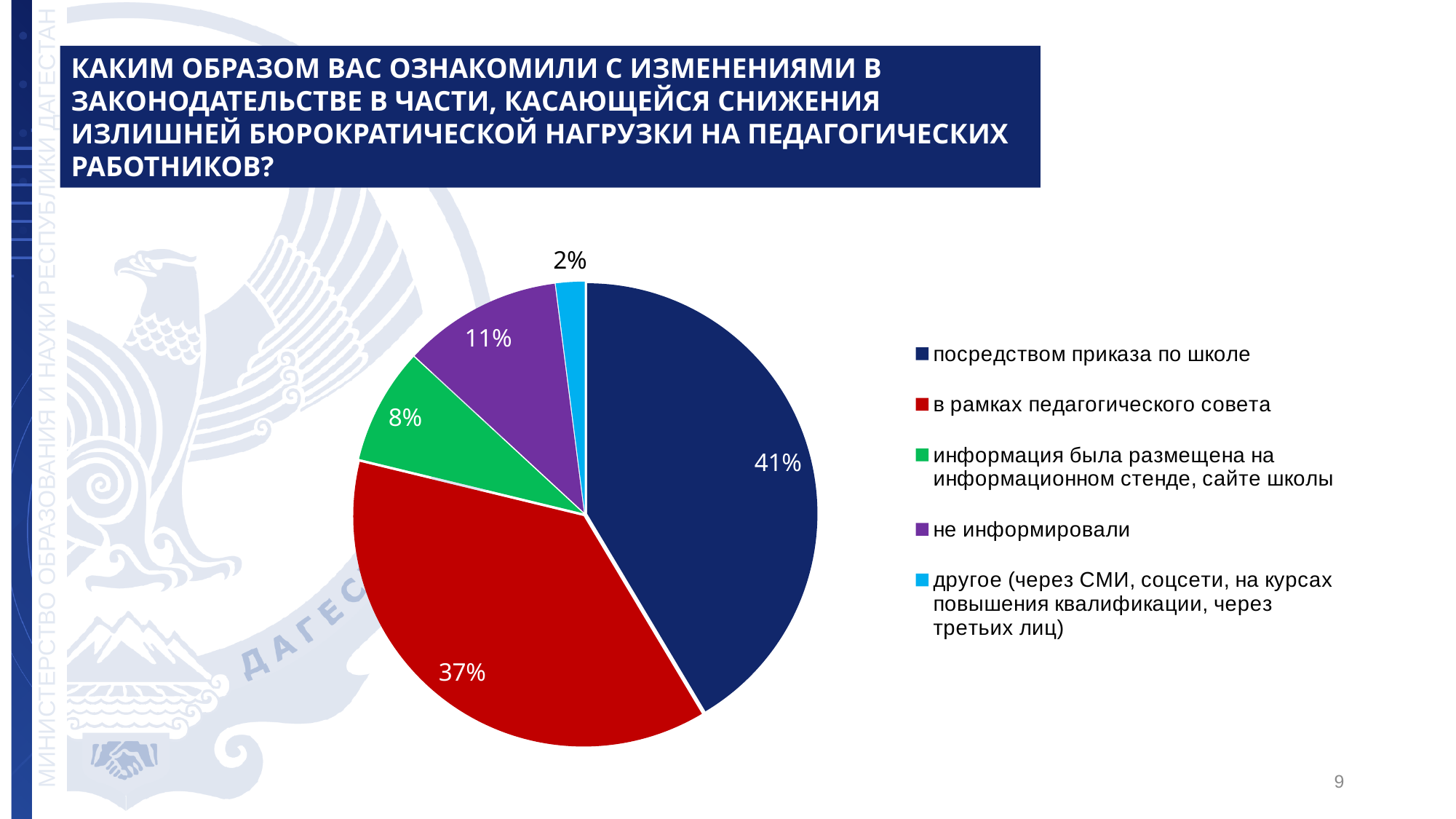
Which category has the smallest slice of the pie? другое (через СМИ, соцсети, на курсах повышения квалификации, через третьих лиц) What colour is the slice for в рамках педагогического совета? red How many categories does the legend list? 5 What is the difference in percentage points between посредством приказа по школе and в рамках педагогического совета? 4 Which is larger: the share for не информировали or the share for информация была размещена на информационном стенде, сайте школы? не информировали What share of respondents chose другое (через СМИ, соцсети, на курсах повышения квалификации, через третьих лиц)? 2% What share of respondents were informed посредством приказа по школе? 41% What share of respondents were informed в рамках педагогического совета? 37% What share of respondents answered that информация была размещена на информационном стенде, сайте школы? 8% What type of chart is shown on the slide? pie chart Which category has the largest slice of the pie? посредством приказа по школе What share of respondents answered не информировали? 11%